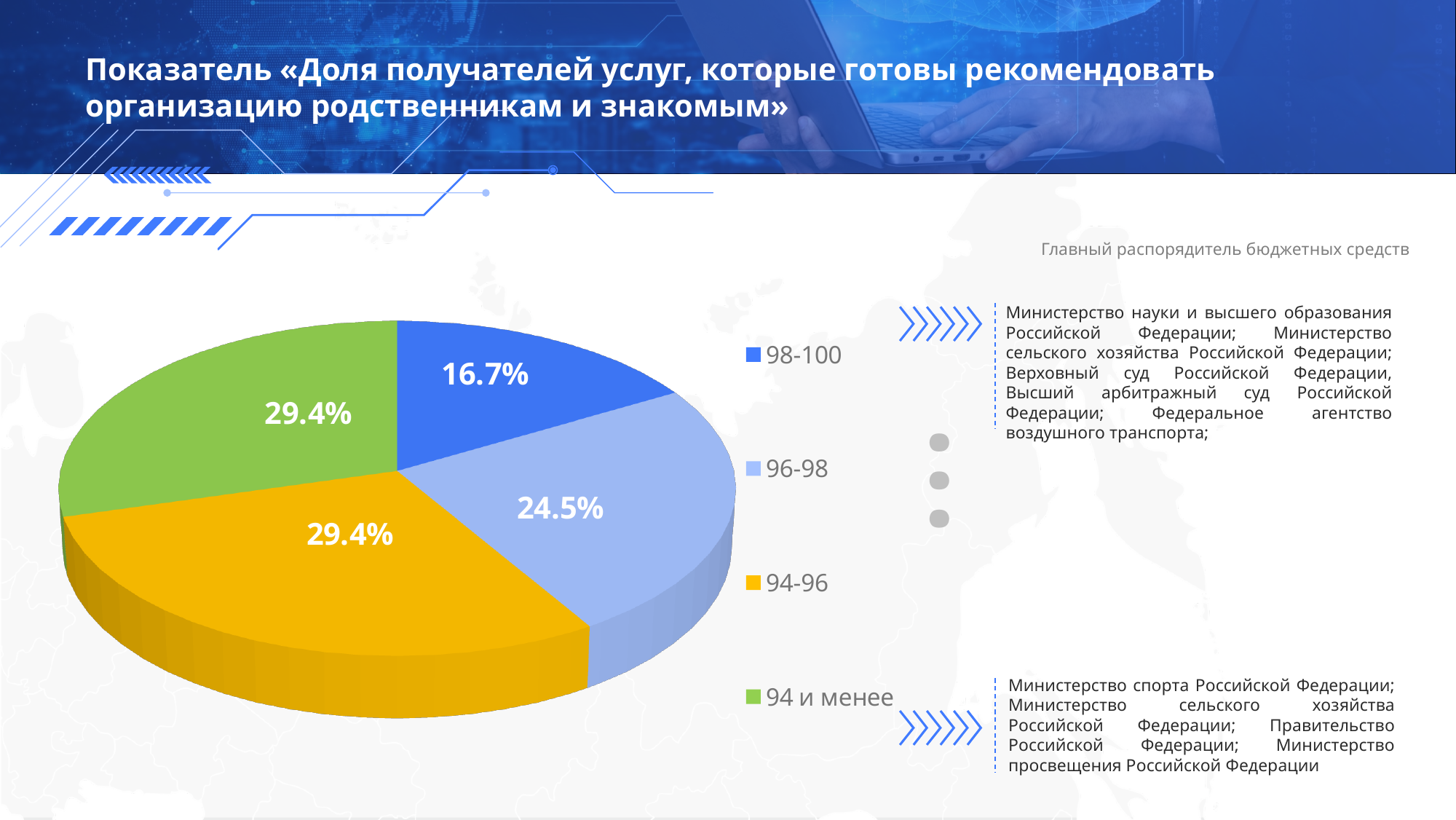
Which category has the smallest slice of the pie? 98-100 What share of the pie does the "98-100" slice represent? 16.7% How many categories are shown in the pie chart? 4 What colour is the "94 и менее" slice in the pie chart? green What is the difference in percentage points between the "96-98" slice and the "98-100" slice? 7.8 What is the value shown for the "94-96" category? 29.4% What is the value shown for the "94 и менее" category? 29.4% What type of chart is shown on the slide? pie chart How many entries does the legend list? 4 Do the "94-96" and "94 и менее" slices have the same value? Yes Which is larger, the slice for "96-98" or the slice for "98-100"? 96-98 What is the value shown for the "96-98" category? 24.5%